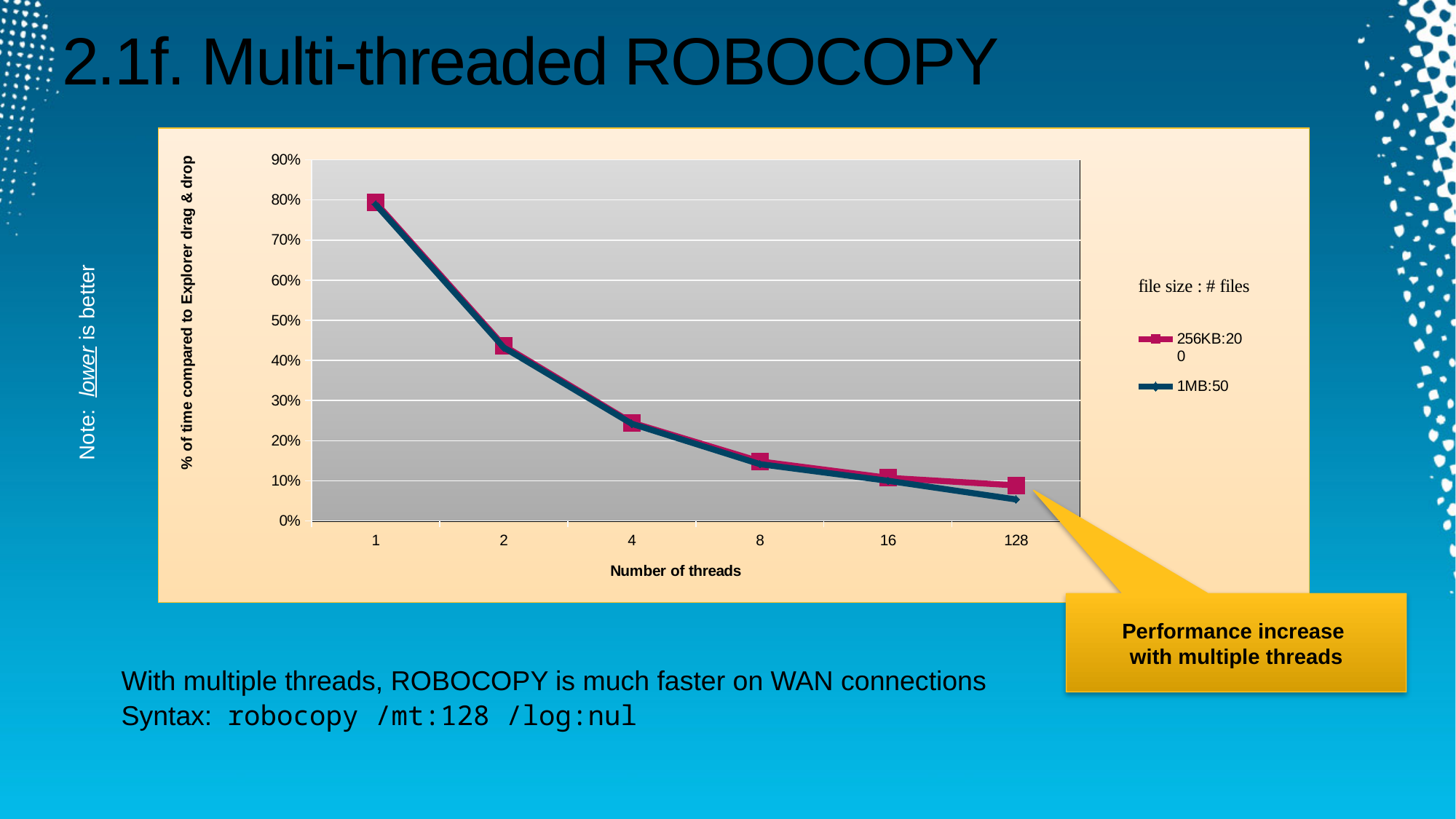
For the 256KB:200 series, at which number of threads is the value highest? 1 How many thread-count categories are plotted along the x axis? 6 How many series does the legend list? 2 Is the value for the 1MB:50 series at 128 threads greater or less than 10%? less For the 1MB:50 series, at which number of threads is the value lowest? 128 Is the value for the 256KB:200 series at 2 threads greater or less than 50%? less What kind of chart is shown on the slide? line chart Is the value for the 256KB:200 series at 1 thread greater or less than 70%? greater What is the title of the x axis? Number of threads What is the title shown above the legend? file size : # files Do the values for the 256KB:200 series rise or fall as the number of threads increases? fall